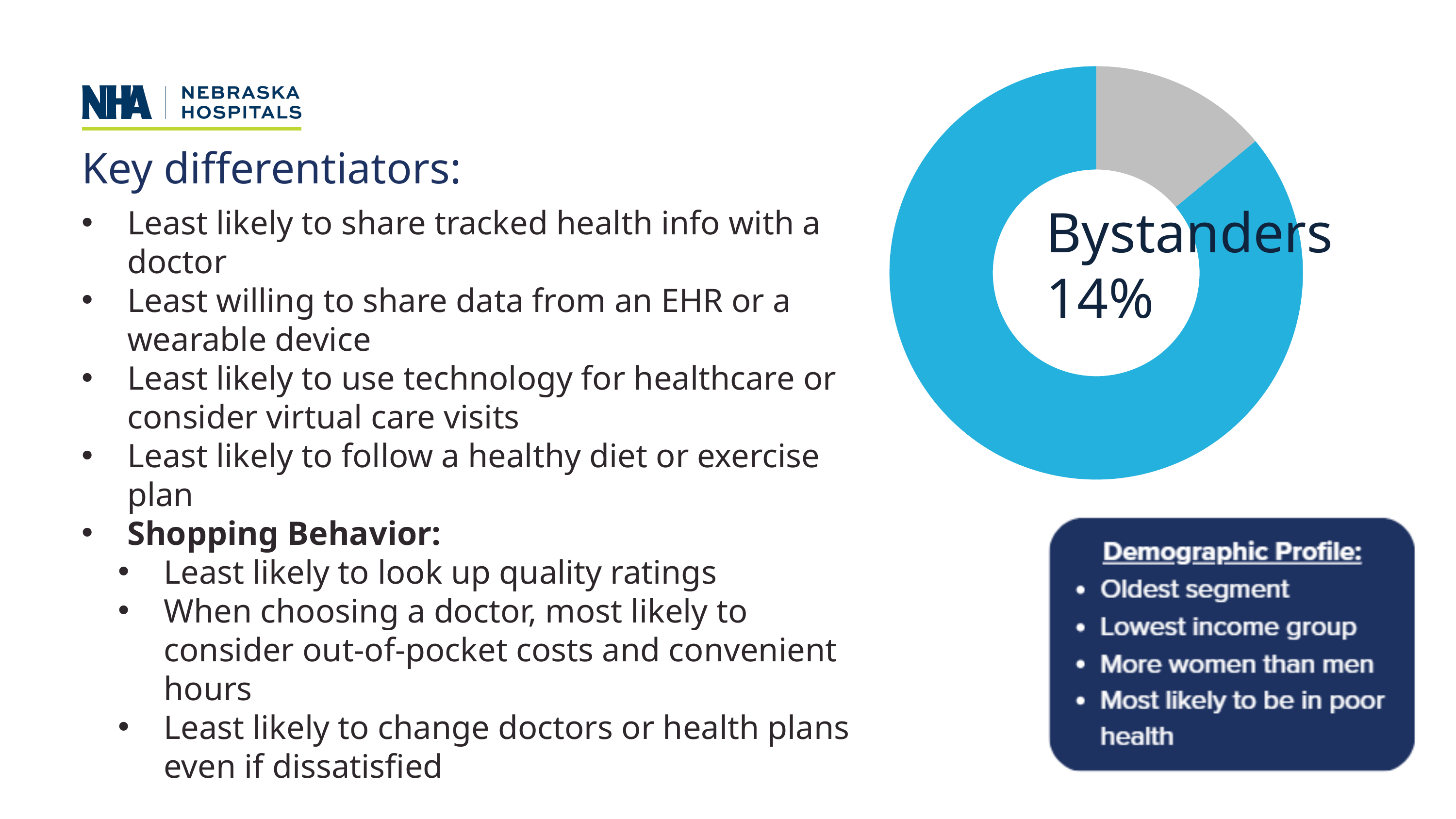
How many slices does the donut chart have? 2 What percentage is shown for Bystanders in the donut chart? 14% What kind of chart is shown on the right of the slide? pie chart (donut) What colour is the slice representing the 14% Bystanders share in the donut chart? grey In the donut chart, which slice is larger, the blue one or the grey one? blue What segment name is printed in the center of the donut chart? Bystanders